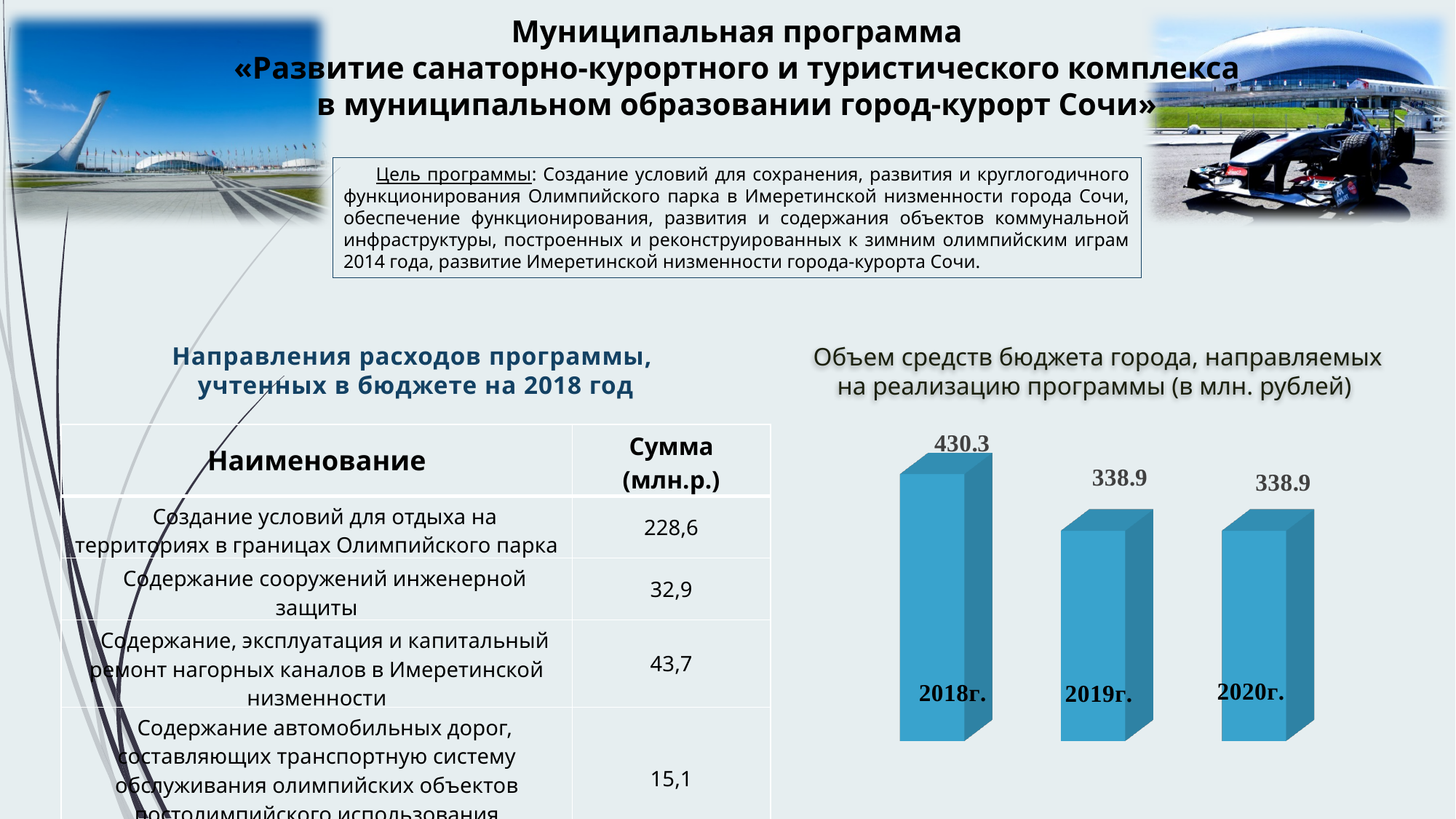
What is the value for 2020г. in the chart? 338.9 What is the value for 2018г. in the chart? 430.3 What is the difference between the values for 2018г. and 2019г.? 91.4 Which year has the highest value in the chart? 2018г. In what units are the values in the chart expressed, according to its title? млн. рублей Do the values rise or fall from 2018г. to 2019г.? fall What is the value for 2019г. in the chart? 338.9 What is the total of the values for 2018г., 2019г. and 2020г.? 1108.1 How many bars are shown in the chart? 3 Which is larger, the value for 2018г. or the value for 2020г.? 2018г. What kind of chart is shown on the slide? bar chart What is the difference between the values for 2019г. and 2020г.? 0